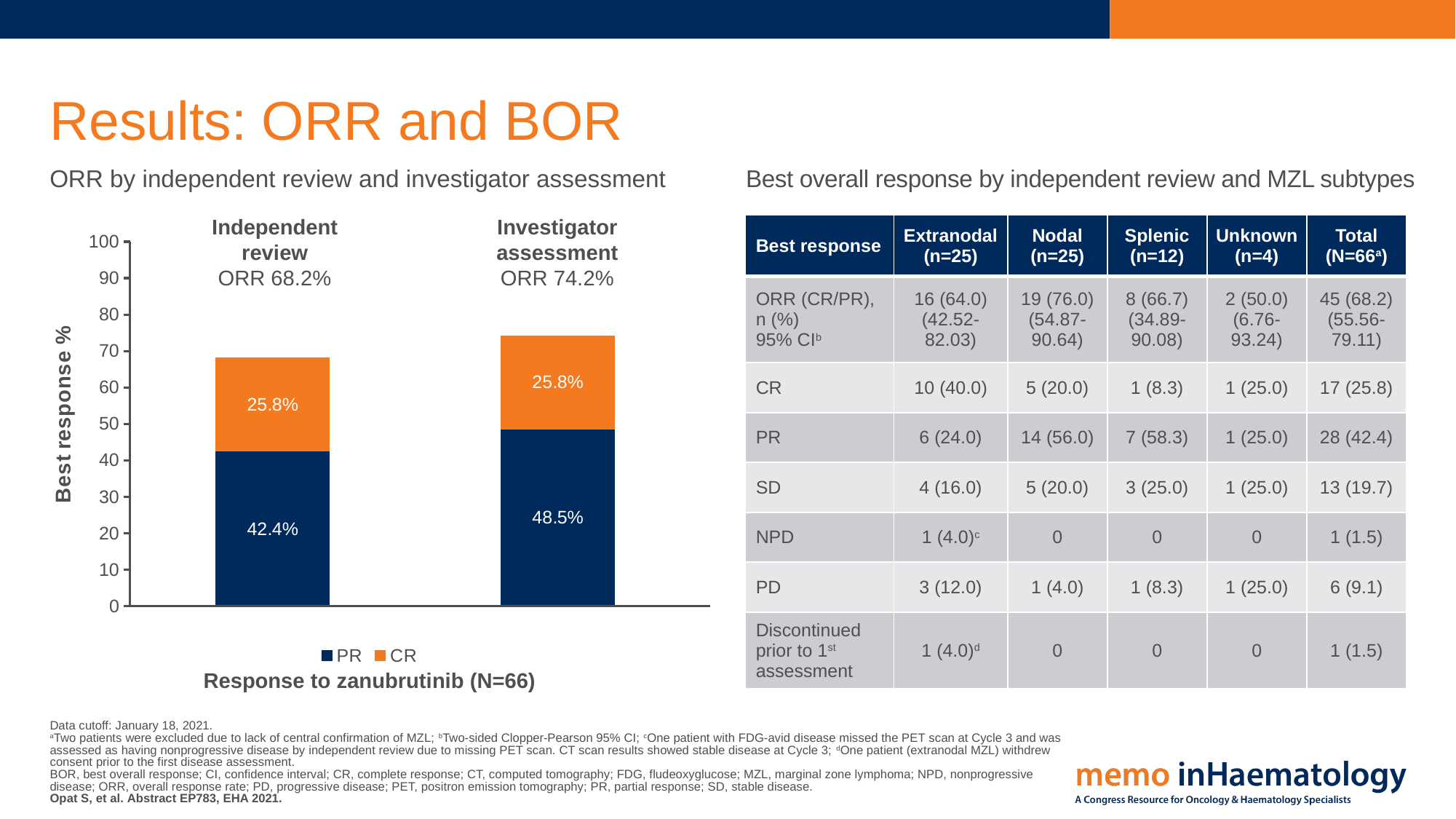
In the bar chart, what ORR is shown for Investigator assessment? 74.2% In the bar chart, what is the total height of the Independent review stacked bar (PR plus CR)? 68.2% What type of chart is shown on the left of the slide? Stacked bar chart In the bar chart, what is the difference between the PR values for Investigator assessment and Independent review? 6.1 percentage points What is the y-axis title of the bar chart? Best response % In the bar chart, what is the PR value for Investigator assessment? 48.5% How many series does the bar chart legend list? 2 In the bar chart, what ORR is shown for Independent review? 68.2% In the bar chart, what is the PR value for Independent review? 42.4% In the bar chart, which category has the higher PR value, Independent review or Investigator assessment? Investigator assessment How many categories (bars) are shown in the bar chart? 2 In the bar chart, what is the CR value for Investigator assessment? 25.8%